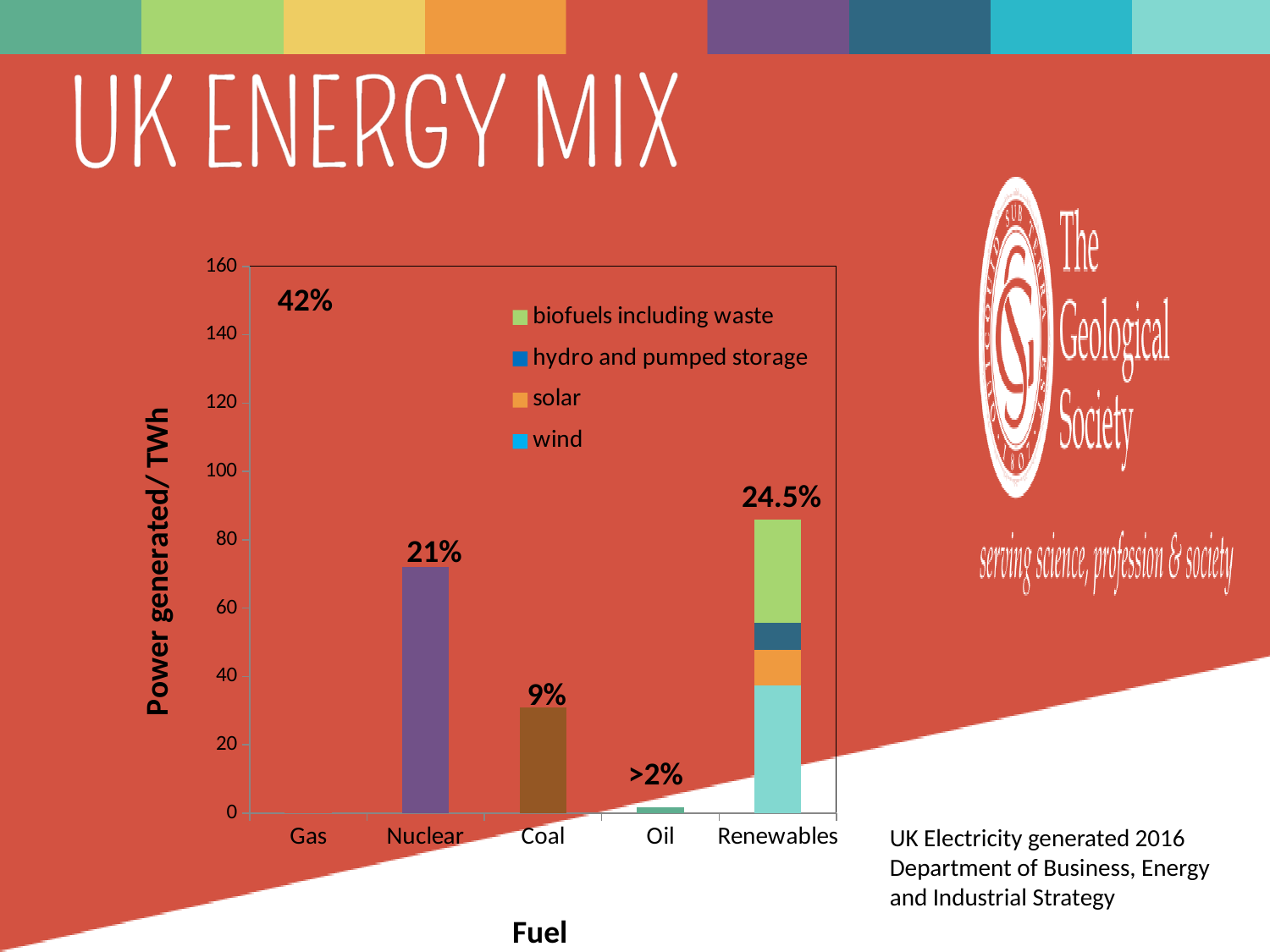
What percentage label is shown for Nuclear? 21% What percentage label is shown for Oil? >2% Is the power generated for Coal greater or less than 40 TWh? less How many entries does the legend list? 4 Which fuel has the highest percentage label on the chart? Gas Which bar is taller, Nuclear or Coal? Nuclear Which fuel has the shortest bar on the chart? Oil What percentage label is shown for Coal? 9% How many fuel categories are shown on the x axis? 5 What percentage label is shown for Renewables? 24.5% What is the title of the y axis? Power generated/ TWh Is the power generated for Nuclear greater or less than 60 TWh? greater